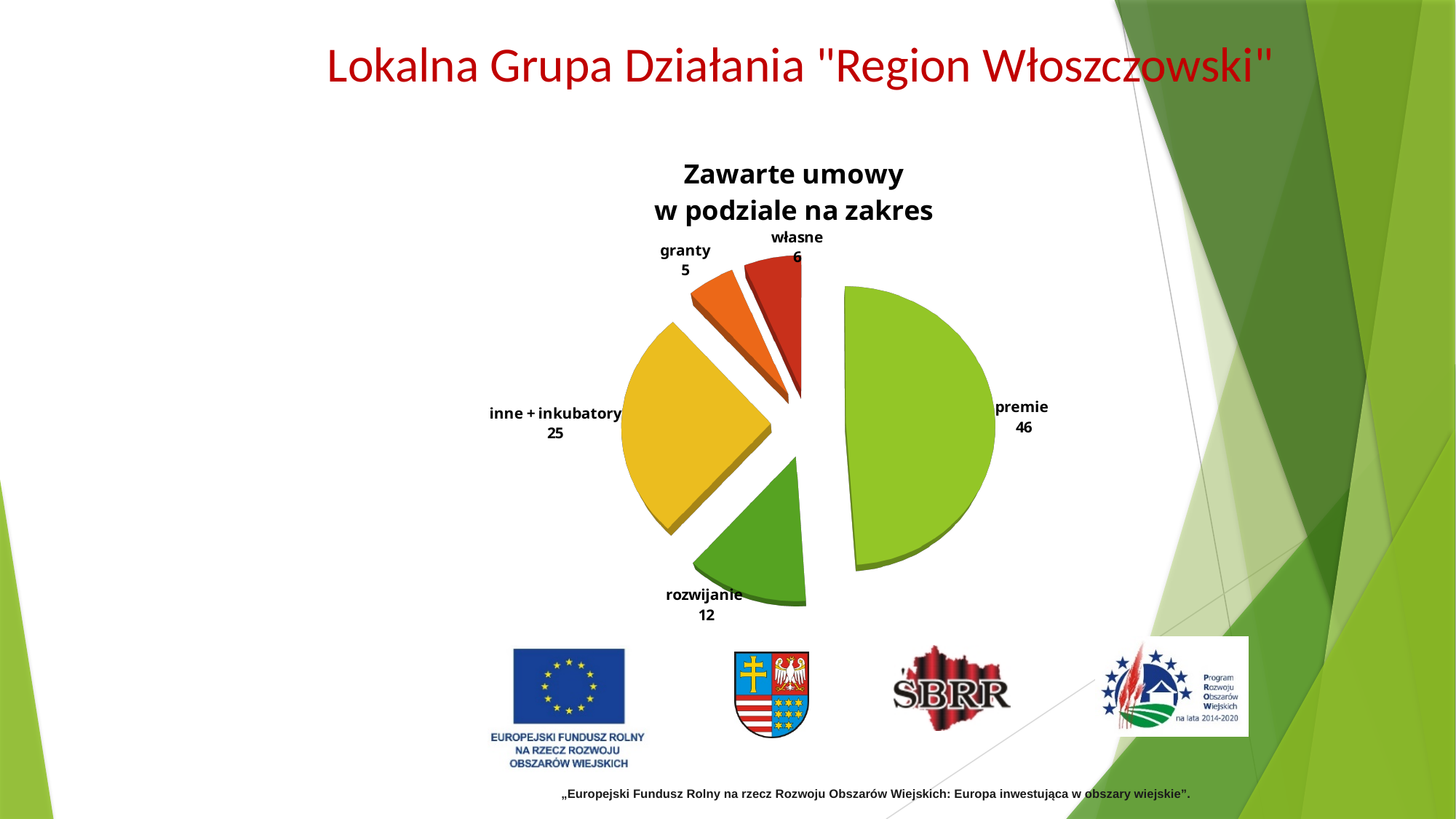
What is the difference between the values for premie and inne + inkubatory? 21 Which category has the smallest slice? granty What type of chart is shown on the slide? pie chart What is the total of all slices in the pie chart? 94 What is the value for granty? 5 Which category has the largest slice? premie What is the title of the chart? Zawarte umowy w podziale na zakres What is the value for własne? 6 What is the value for inne + inkubatory? 25 What is the value for premie? 46 What is the value for rozwijanie? 12 How many slices does the pie chart have? 5